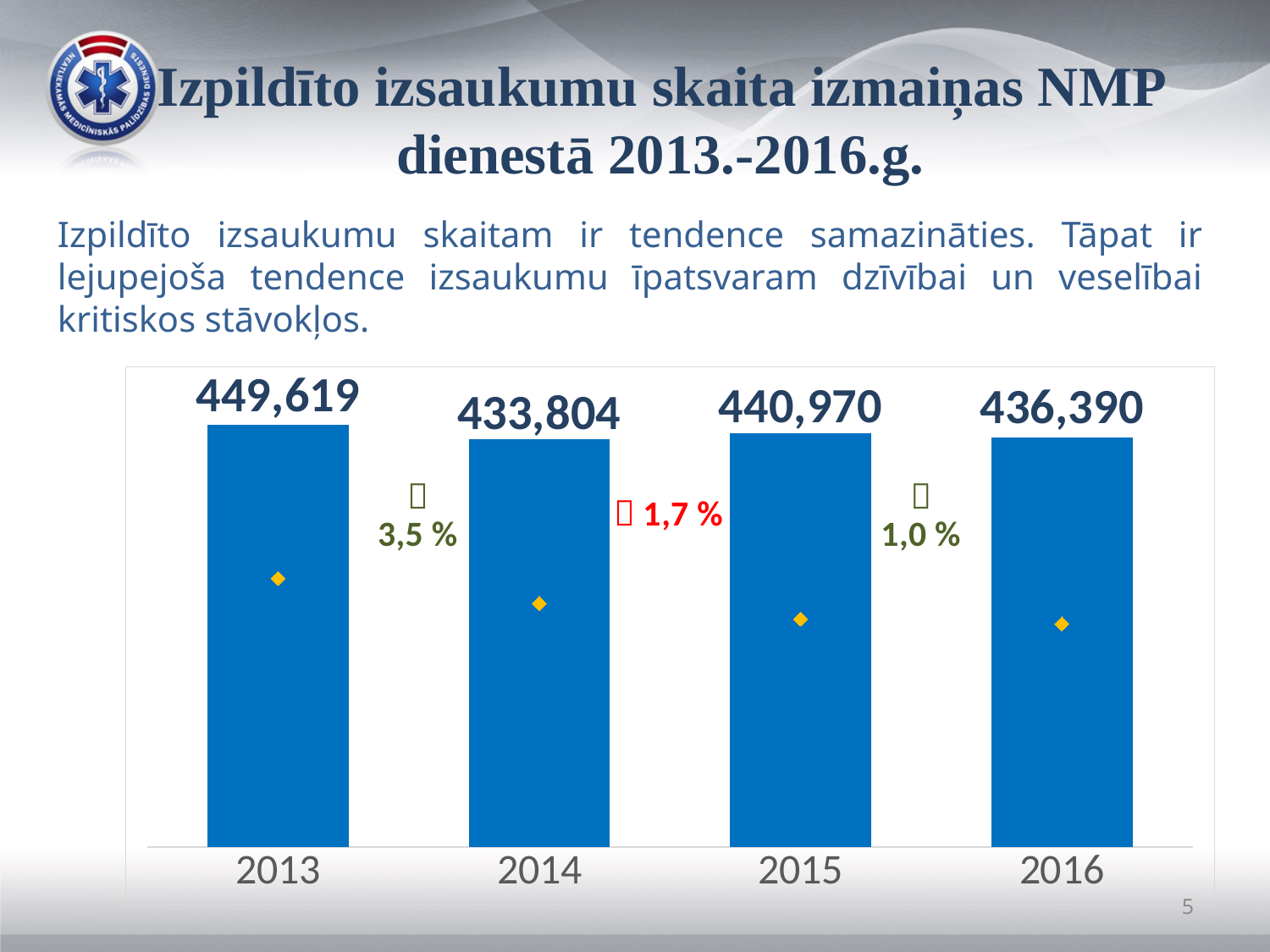
What is the value of the bar for 2014? 433,804 What is the value of the bar for 2016? 436,390 Which year has the highest value? 2013 How many years are shown on the x axis? 4 What is the difference between the values for 2013 and 2014? 15,815 Which is larger, the value for 2014 or the value for 2015? 2015 What percentage change is annotated between the 2014 and 2015 bars? 1,7 % What kind of chart is shown on the slide? bar chart What is the value of the bar for 2015? 440,970 What is the value of the bar for 2013? 449,619 What is the difference between the values for 2015 and 2016? 4,580 Which year has the lowest value? 2014